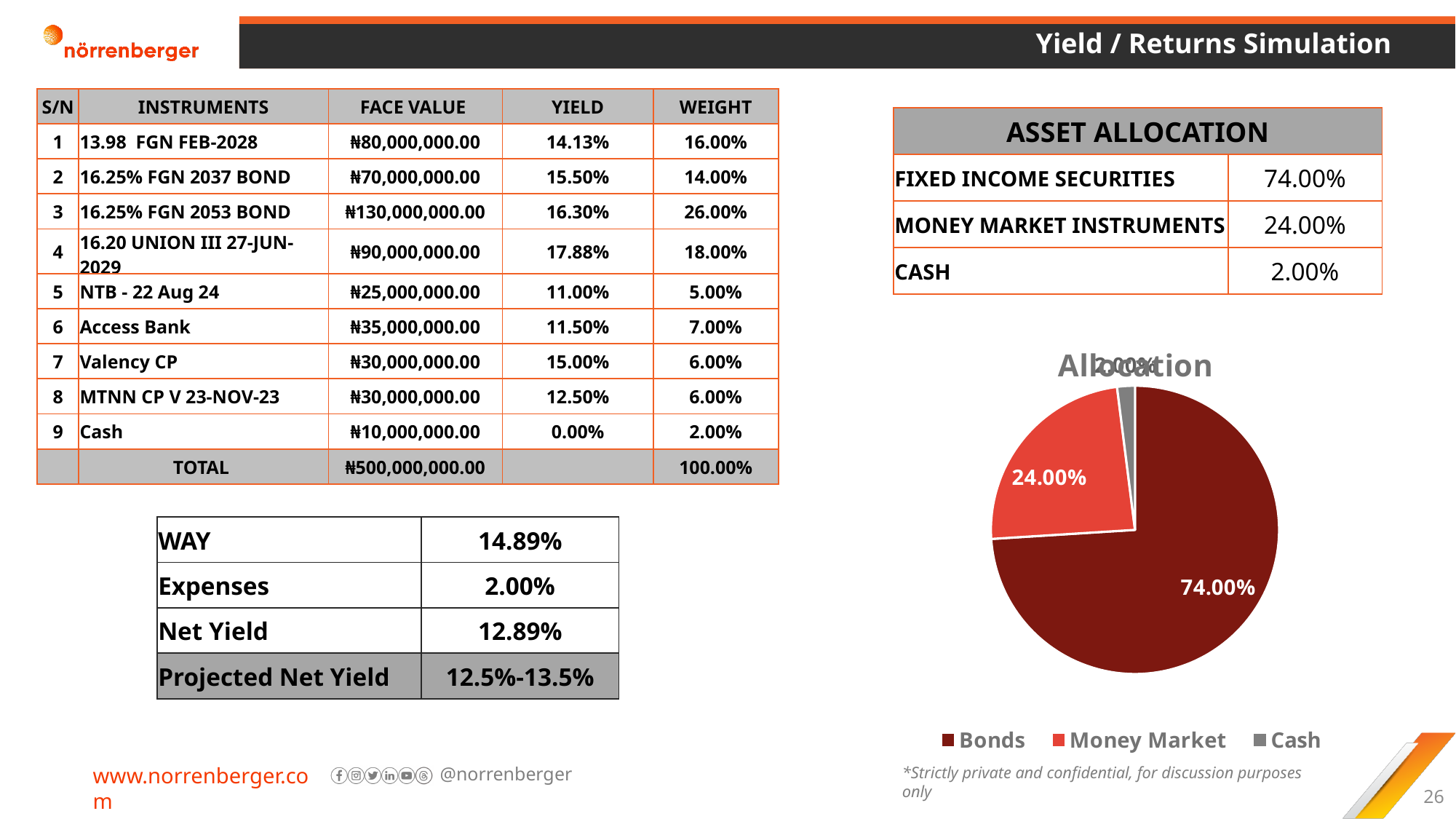
What kind of chart is shown on the slide? pie chart What is the title of the pie chart? Allocation What share of the pie chart is Cash? 2.00% What share of the pie chart is Money Market? 24.00% In the pie chart, which is larger, Money Market or Cash? Money Market Which slice of the pie chart is the largest? Bonds How many entries does the pie chart's legend list? 3 What share of the pie chart is Bonds? 74.00% Which slice of the pie chart is the smallest? Cash Which legend entry in the pie chart is shown in grey? Cash What is the difference between the Bonds and Money Market shares in the pie chart? 50.00% How many slices does the pie chart have? 3